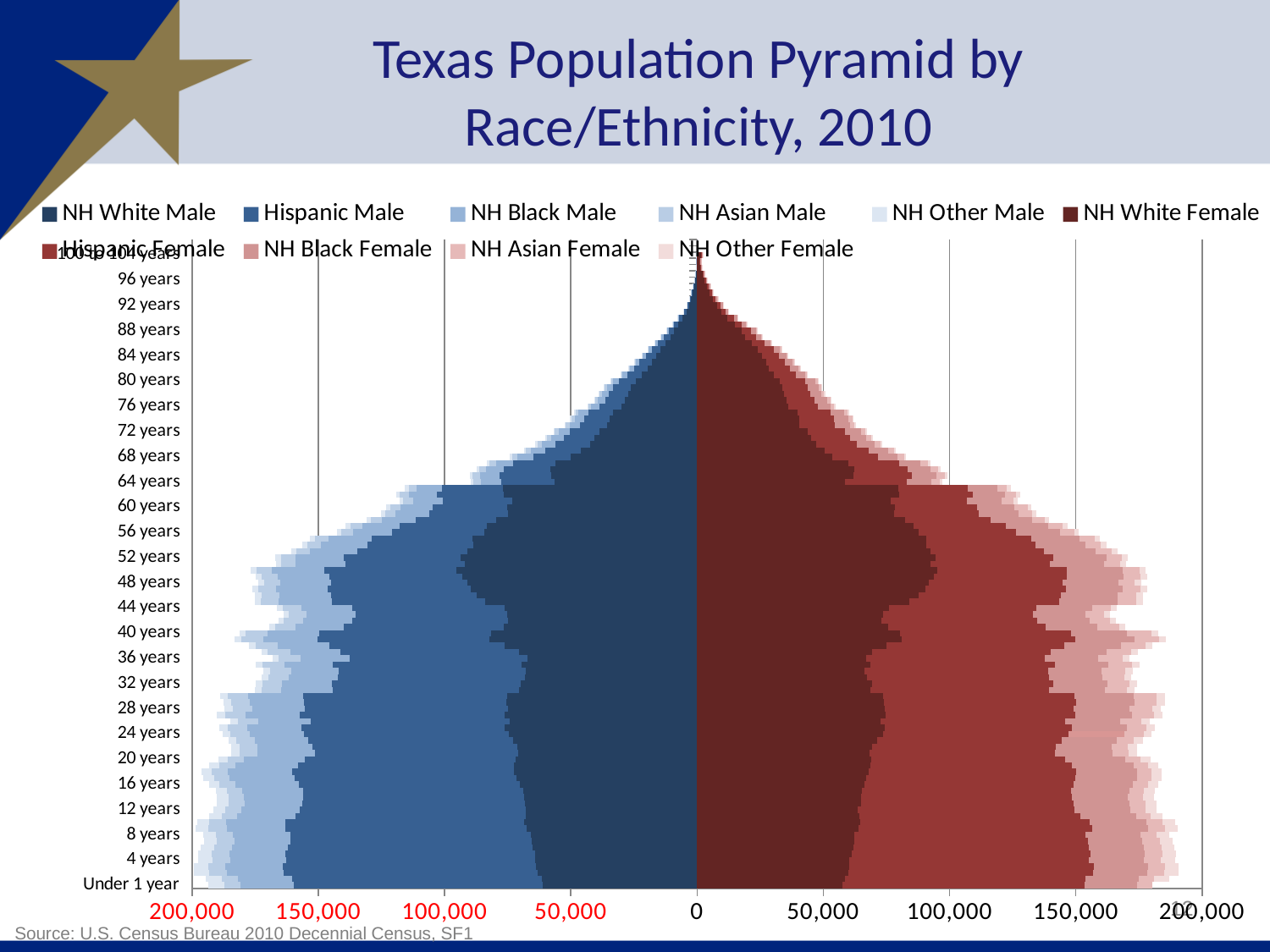
At 88 years, which is larger: the total male population or the total female population? Female How many series does the legend list? 10 Is the total female population at 40 years greater or less than 150,000? greater Moving from the youngest ages to the oldest ages, do the total population bars generally rise or fall? Fall Which legend entry is listed first? NH White Male Which is larger: the NH White Male population at 48 years or at 80 years? 48 years What is the title of the chart? Texas Population Pyramid by Race/Ethnicity, 2010 Is the total male population at 80 years greater or less than 50,000? less Is the total male population at 64 years greater or less than 150,000? less What kind of chart is shown on the slide? Bar chart (population pyramid)